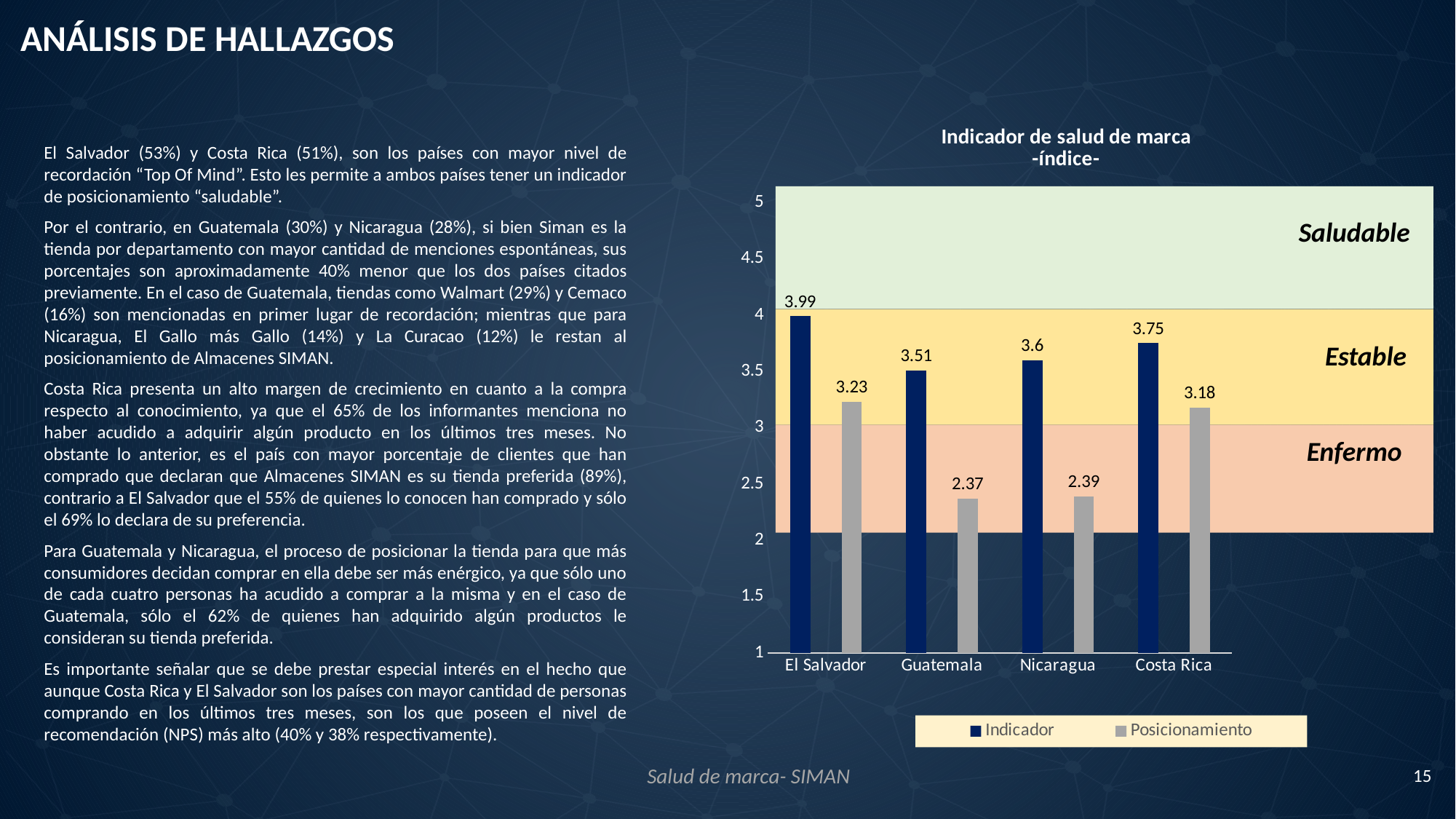
What is the title of the chart? Indicador de salud de marca -índice- Is the Posicionamiento value for Nicaragua greater or less than 3? less What kind of chart is shown? bar chart How many countries are shown on the x axis? 4 What is the Indicador value for Costa Rica? 3.75 How many series does the legend list? 2 What is the Indicador value for El Salvador? 3.99 Which is larger, the Posicionamiento value for El Salvador or for Costa Rica? El Salvador What is the difference between the Indicador and Posicionamiento values for Nicaragua? 1.21 What is the Posicionamiento value for Guatemala? 2.37 Which country has the highest Indicador value? El Salvador Which country has the lowest Posicionamiento value? Guatemala